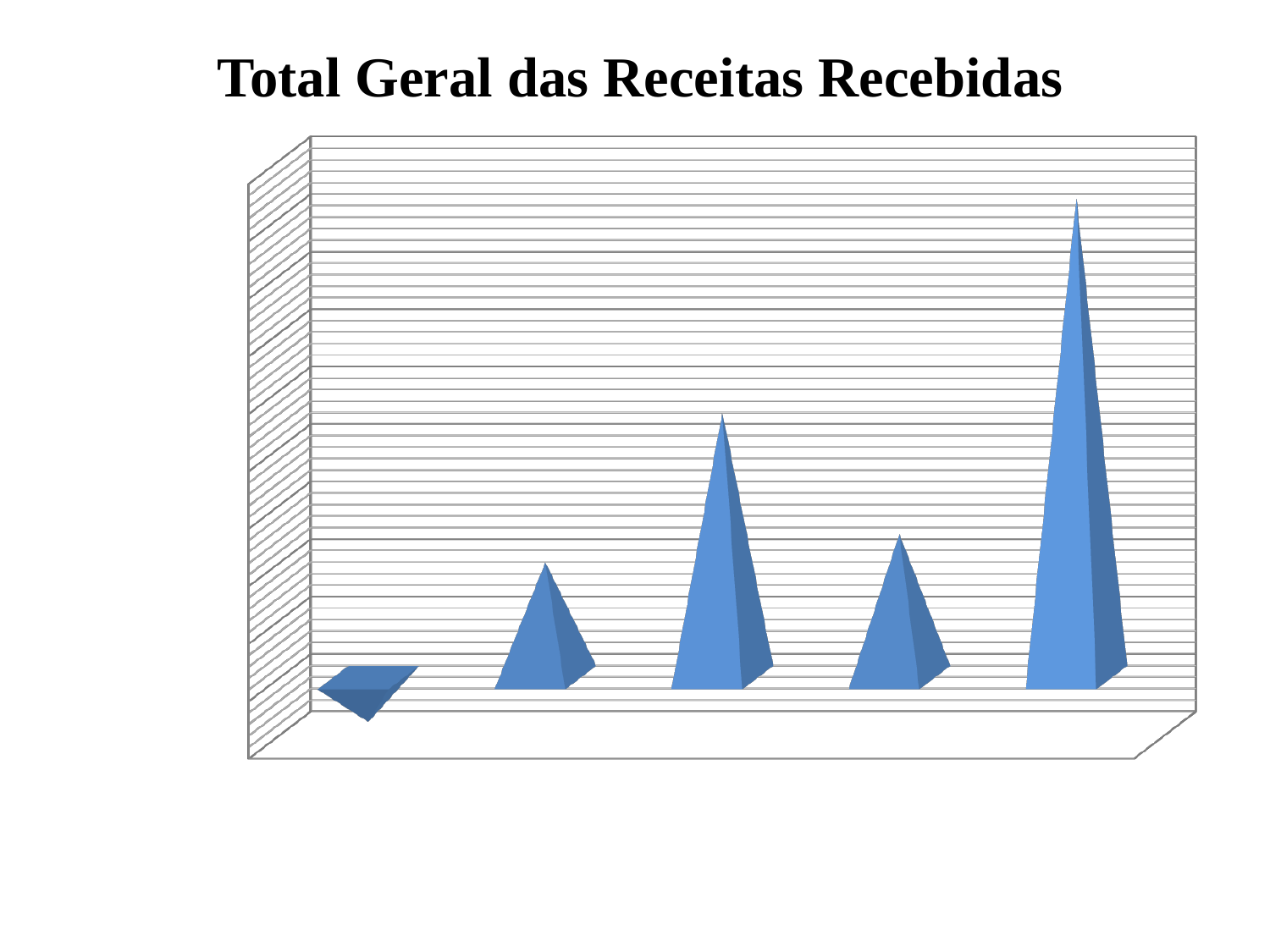
Which is taller, the first bar or the second bar from the left? the second bar What kind of chart is shown on the slide? bar chart Which bar is the shortest in the chart, counting from the left? the first (leftmost) bar What is the title of the chart? Total Geral das Receitas Recebidas Which is taller, the third bar or the fifth bar from the left? the fifth bar How many bars are plotted in the chart? 5 Do the bar heights rise steadily from left to right across the chart? No Which bar is the tallest in the chart, counting from the left? the fifth (rightmost) bar What colour are the bars in the chart? blue Which is taller, the third bar or the fourth bar from the left? the third bar